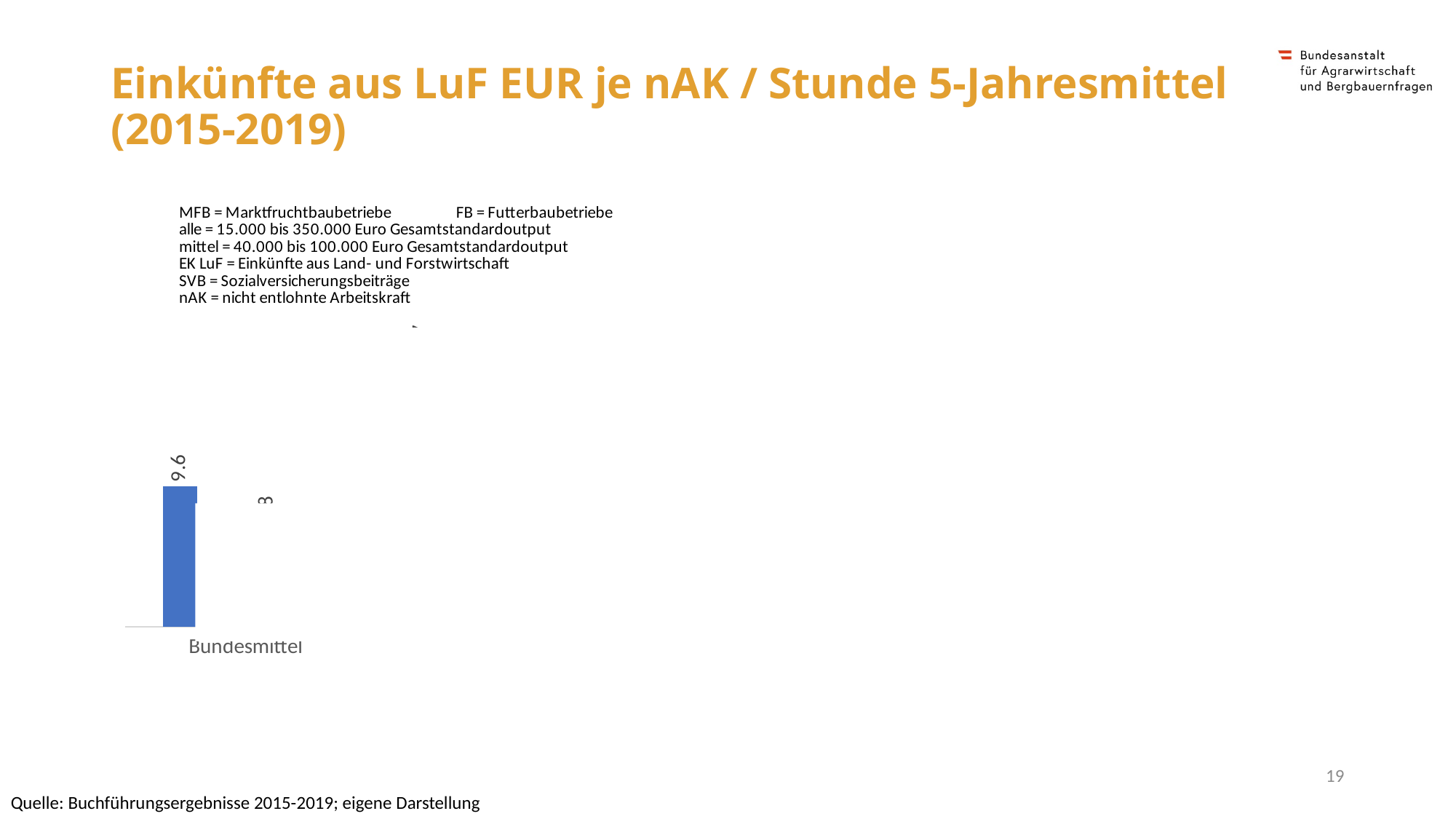
What is the value shown for Bundesmittel? 9,6 What colour is the bar for Bundesmittel? blue What kind of chart is shown on the slide? bar chart What is the category label printed under the visible bar? Bundesmittel